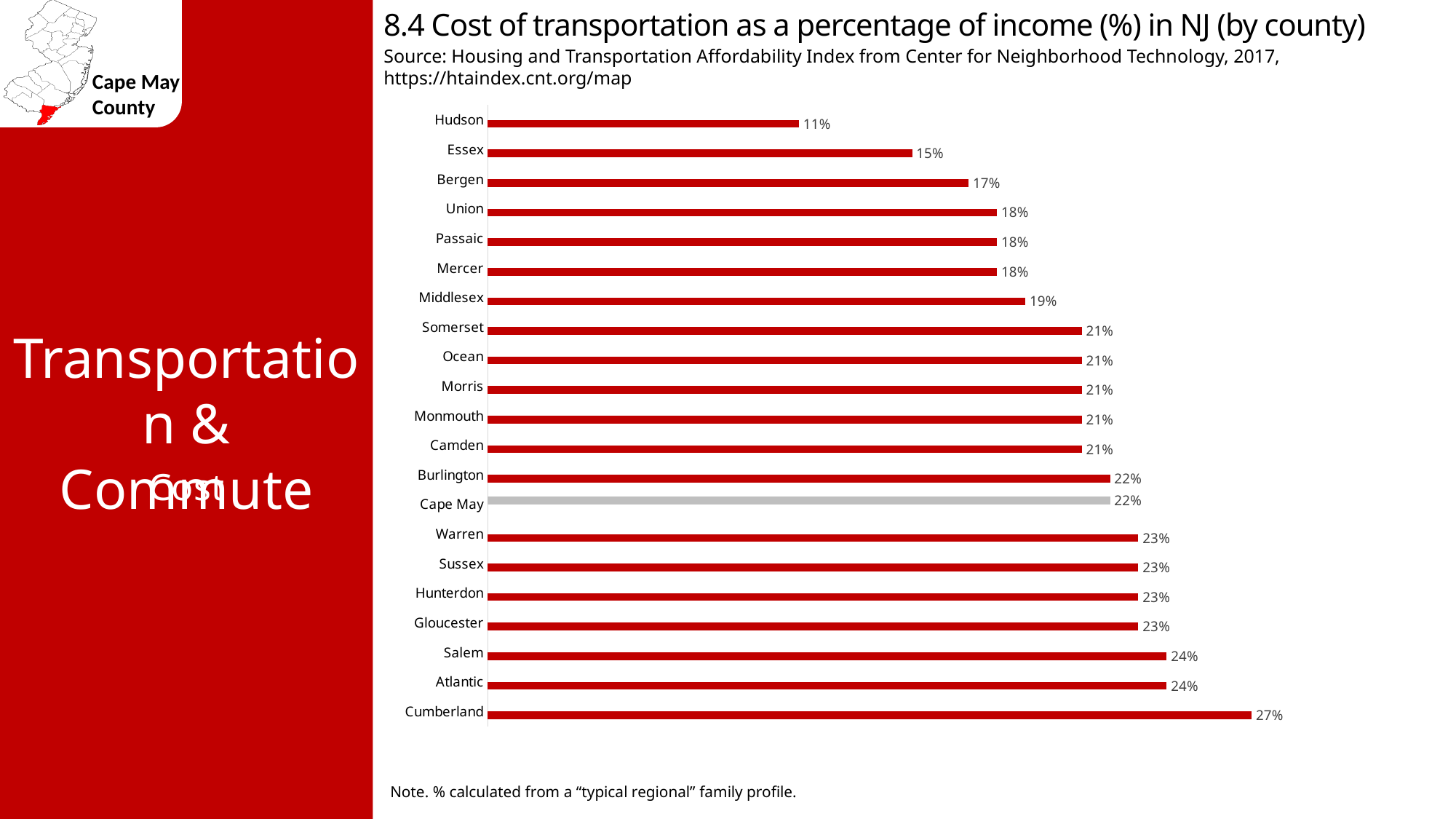
What is the difference between the values for Cumberland and Hudson? 16% What is the value shown for Middlesex county? 19% What is the value shown for Hudson county? 11% What is the cost of transportation as a percentage of income for Cape May county? 22% Which county has a larger value, Atlantic or Somerset? Atlantic Which county has a larger value, Essex or Salem? Salem Which county's bar is shown in grey rather than red? Cape May Which county has the lowest cost of transportation as a percentage of income? Hudson What type of chart is shown on the slide? Bar chart What is the difference between the values for Cape May and Bergen? 5% How many counties are shown in the chart? 21 Which county has the highest cost of transportation as a percentage of income? Cumberland